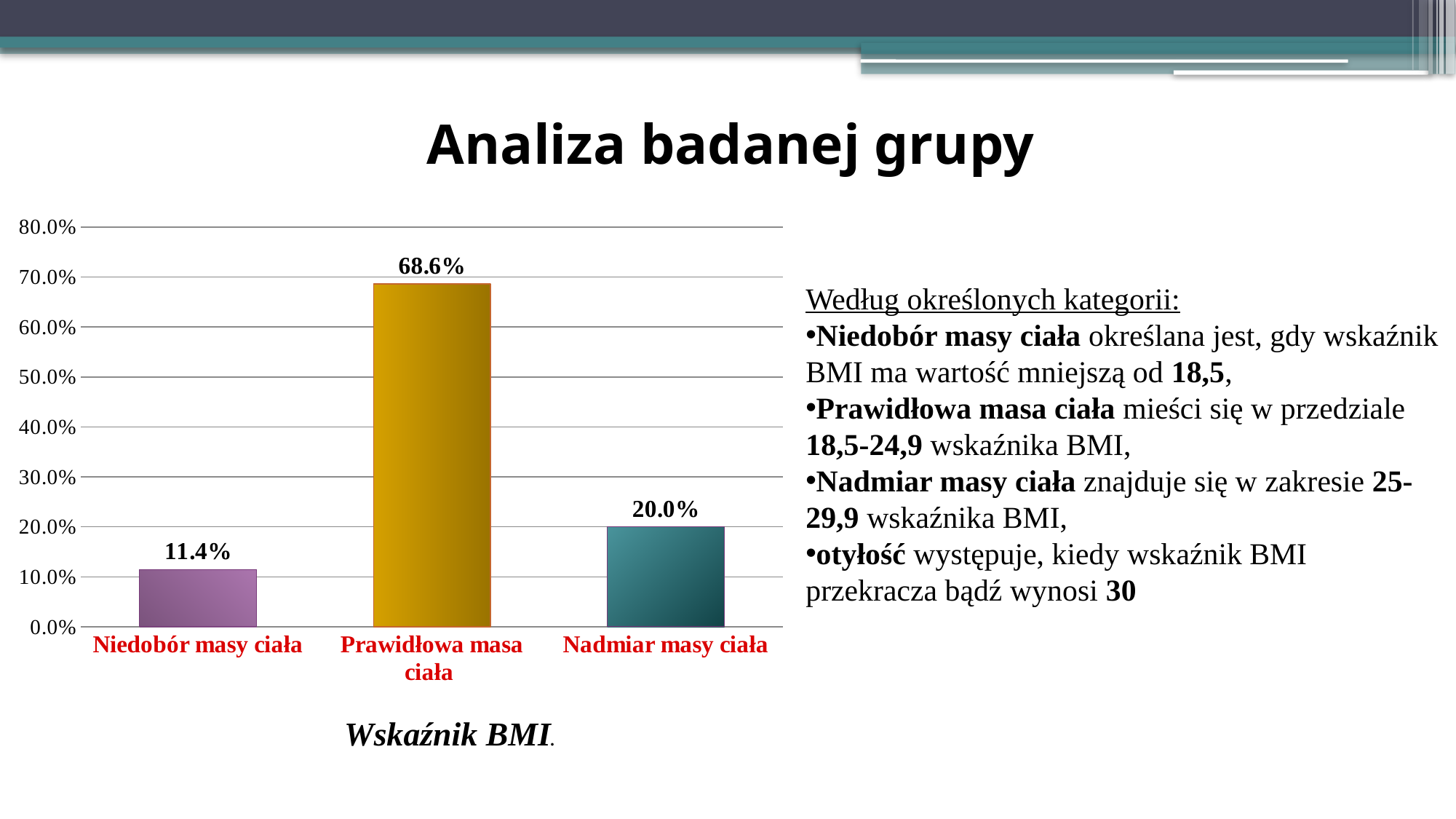
What is the value for Prawidłowa masa ciała? 68.6% What is the value for Niedobór masy ciała? 11.4% What is the difference between the values for Prawidłowa masa ciała and Nadmiar masy ciała? 48.6% What is the value for Nadmiar masy ciała? 20.0% What is the difference between the values for Nadmiar masy ciała and Niedobór masy ciała? 8.6% Is the value for Prawidłowa masa ciała greater or less than 60.0%? greater Which category has the lowest value? Niedobór masy ciała What kind of chart is shown on the slide? bar chart What is the caption below the chart? Wskaźnik BMI. Which is larger, the value for Nadmiar masy ciała or the value for Niedobór masy ciała? Nadmiar masy ciała Which category has the highest value? Prawidłowa masa ciała How many categories are shown on the chart? 3